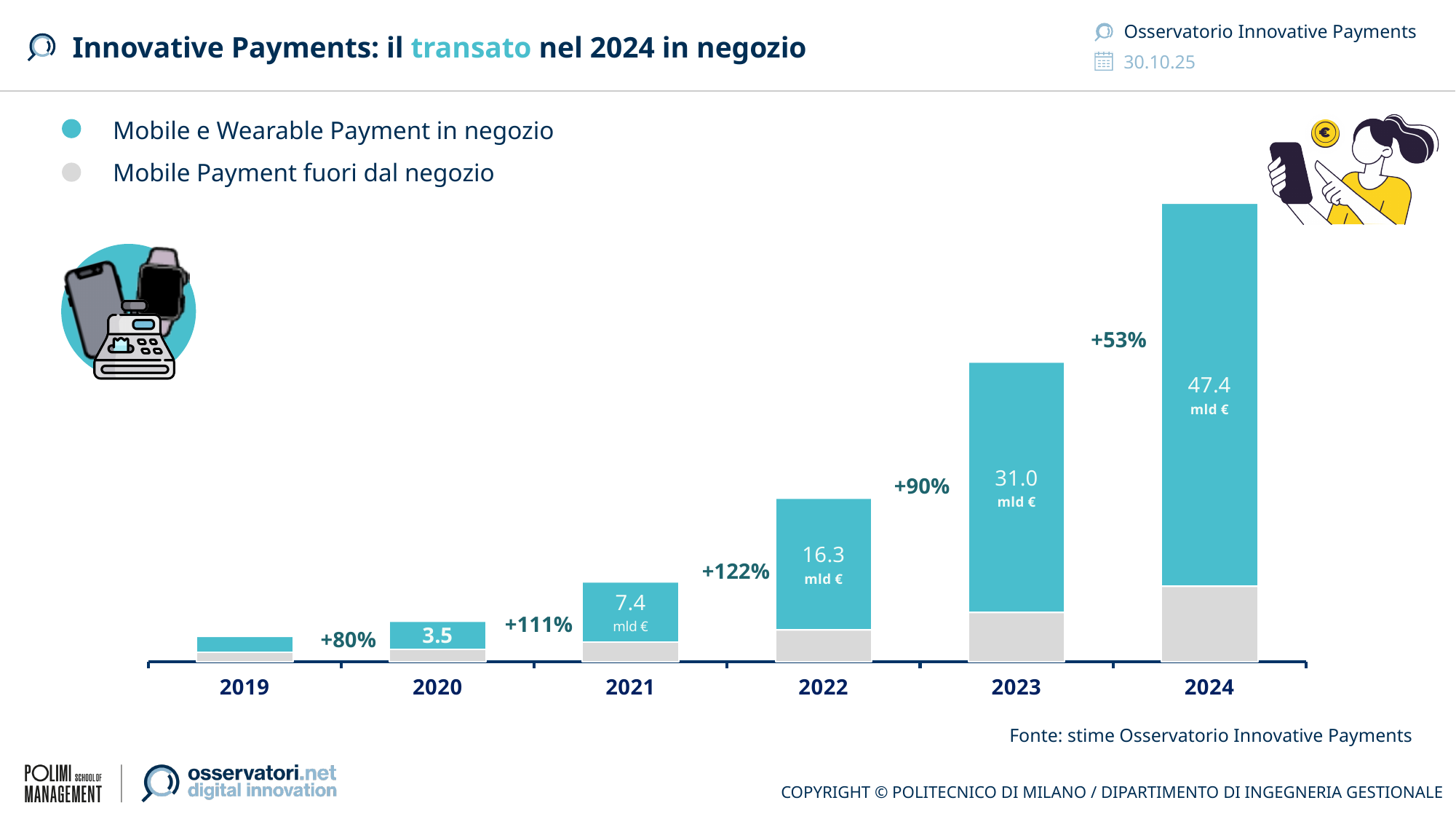
Which year has the tallest bar? 2024 What growth percentage is shown between 2021 and 2022? +122% Do the bar heights rise or fall from 2019 to 2024? rise What value is labelled on the Mobile e Wearable Payment in negozio segment for 2022? 16.3 mld € Which year has the shortest bar? 2019 How many years are shown on the x axis? 6 What value is labelled on the Mobile e Wearable Payment in negozio segment for 2024? 47.4 mld € How many series does the legend list? 2 What value is labelled on the Mobile e Wearable Payment in negozio segment for 2020? 3.5 What is the difference between the Mobile e Wearable Payment in negozio values labelled for 2024 and 2023? 16.4 mld € What growth percentage is shown between 2023 and 2024? +53% Is the Mobile e Wearable Payment in negozio value larger in 2021 or in 2023? 2023